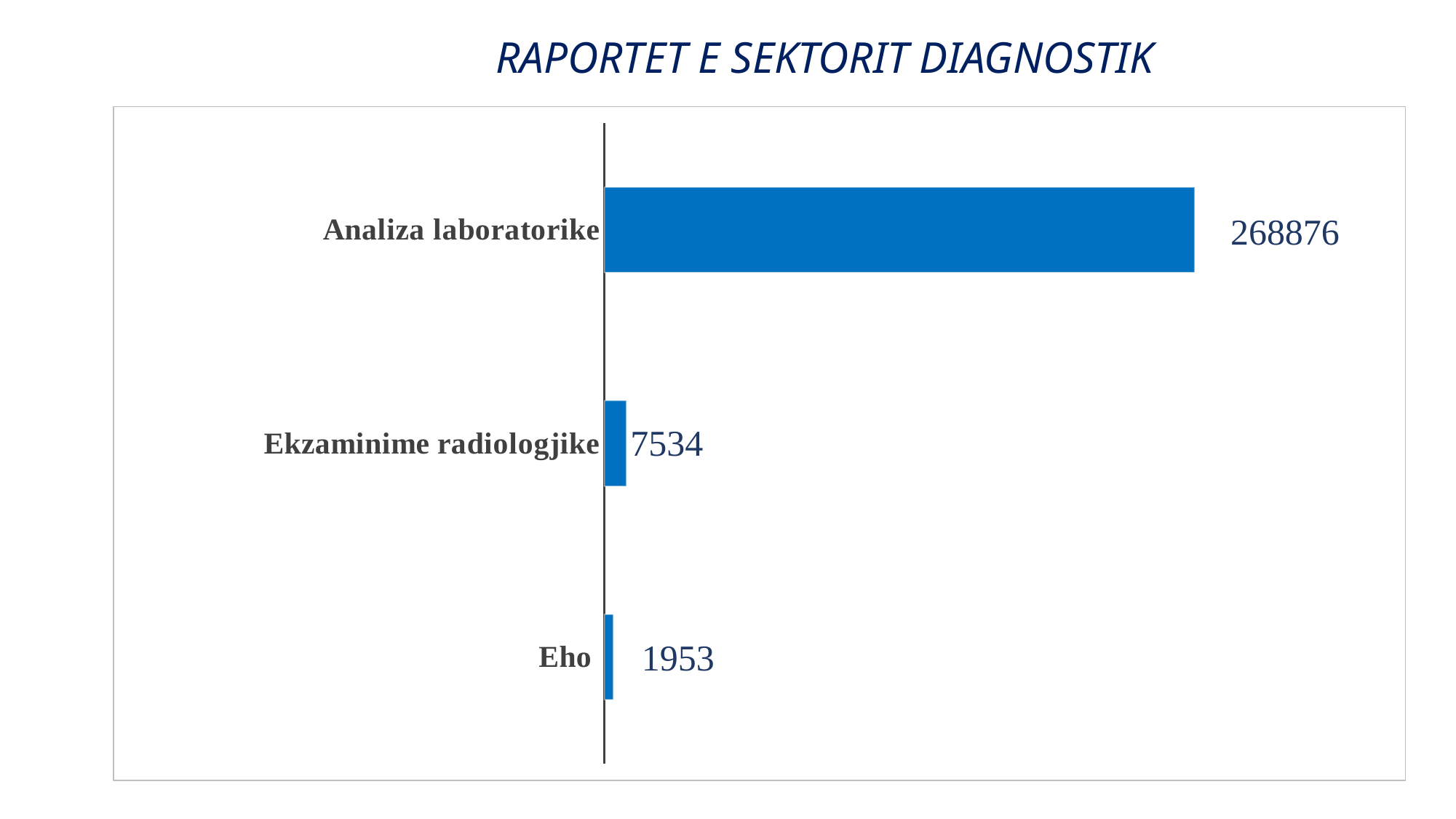
What kind of chart is shown on the slide? Bar chart What is the title of the slide? RAPORTET E SEKTORIT DIAGNOSTIK Which category has the lowest value? Eho How many categories are shown in the chart? 3 What is the value for Eho? 1953 What is the value for Analiza laboratorike? 268876 What colour are the bars in the chart? Blue What is the difference between the values for Ekzaminime radiologjike and Eho? 5581 What is the value for Ekzaminime radiologjike? 7534 Which is larger, the value for Ekzaminime radiologjike or the value for Eho? Ekzaminime radiologjike What is the difference between the values for Analiza laboratorike and Ekzaminime radiologjike? 261342 Which category has the highest value? Analiza laboratorike